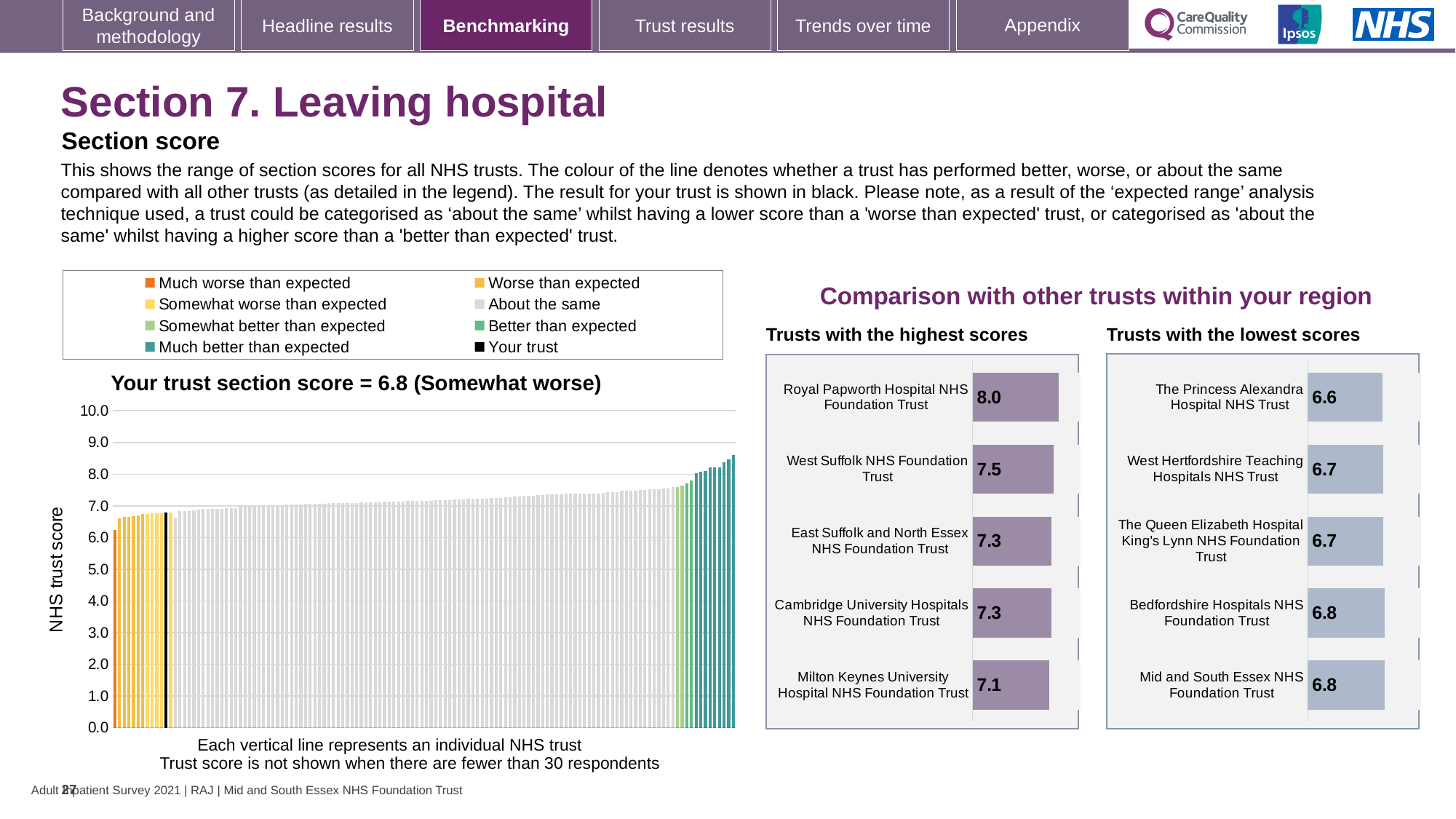
In the 'Trusts with the lowest scores' chart, what is the difference between the scores of Mid and South Essex NHS Foundation Trust and The Princess Alexandra Hospital NHS Trust? 0.2 In the 'Trusts with the lowest scores' chart, which trust has the lowest score? The Princess Alexandra Hospital NHS Trust In the 'Trusts with the highest scores' chart, what is the difference between the scores of Royal Papworth Hospital NHS Foundation Trust and Milton Keynes University Hospital NHS Foundation Trust? 0.9 In the 'Trusts with the highest scores' chart, what is the score for Milton Keynes University Hospital NHS Foundation Trust? 7.1 In the 'Trusts with the highest scores' chart, which trust has the highest score? Royal Papworth Hospital NHS Foundation Trust In the 'Trusts with the highest scores' chart, how many trusts are shown? 5 In the 'Your trust section score' chart, do the trust scores rise or fall from left to right? rise In the 'Your trust section score' chart, what is the section score for your trust? 6.8 In the 'Trusts with the lowest scores' chart, which has the larger score: Bedfordshire Hospitals NHS Foundation Trust or West Hertfordshire Teaching Hospitals NHS Trust? Bedfordshire Hospitals NHS Foundation Trust In the 'Trusts with the highest scores' chart, what is the score for Royal Papworth Hospital NHS Foundation Trust? 8.0 In the 'Your trust section score' chart, is the value of the rightmost (highest) bar greater or less than 8.0? greater In the 'Trusts with the lowest scores' chart, what is the score for The Princess Alexandra Hospital NHS Trust? 6.6